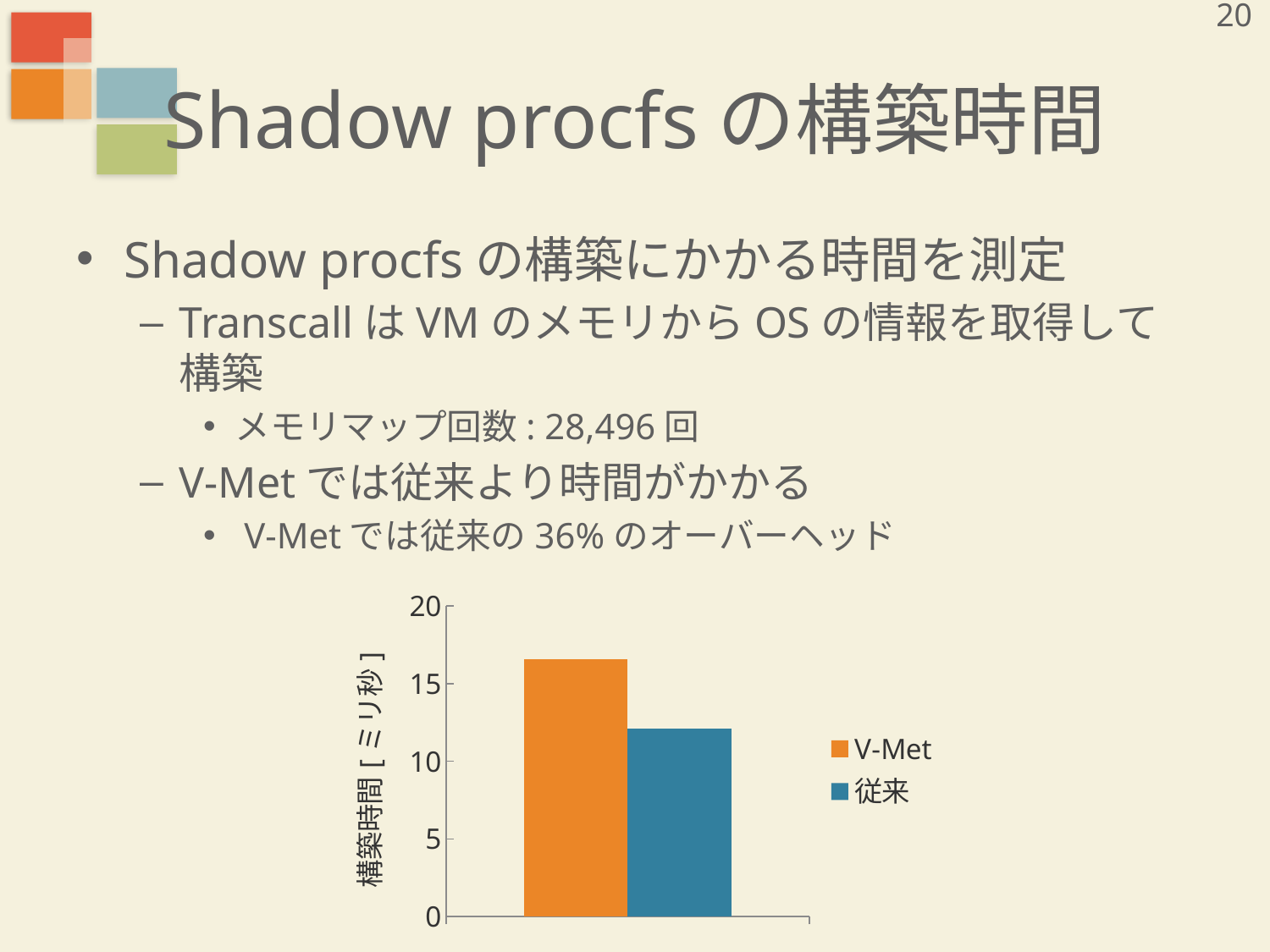
Which series has the highest value in the chart? V-Met Is the value for V-Met greater or less than 15? greater What kind of chart is shown on the slide? bar chart What is the label of the vertical axis of the chart? 構築時間 [ミリ秒] Is the value for 従来 greater or less than 10? greater How many bars are plotted in the chart? 2 Which series has the taller bar, V-Met or 従来? V-Met Is the value for 従来 greater or less than 15? less Which series has the lowest value in the chart? 従来 How many series does the chart legend list? 2 Which colour represents the V-Met series in the chart? orange